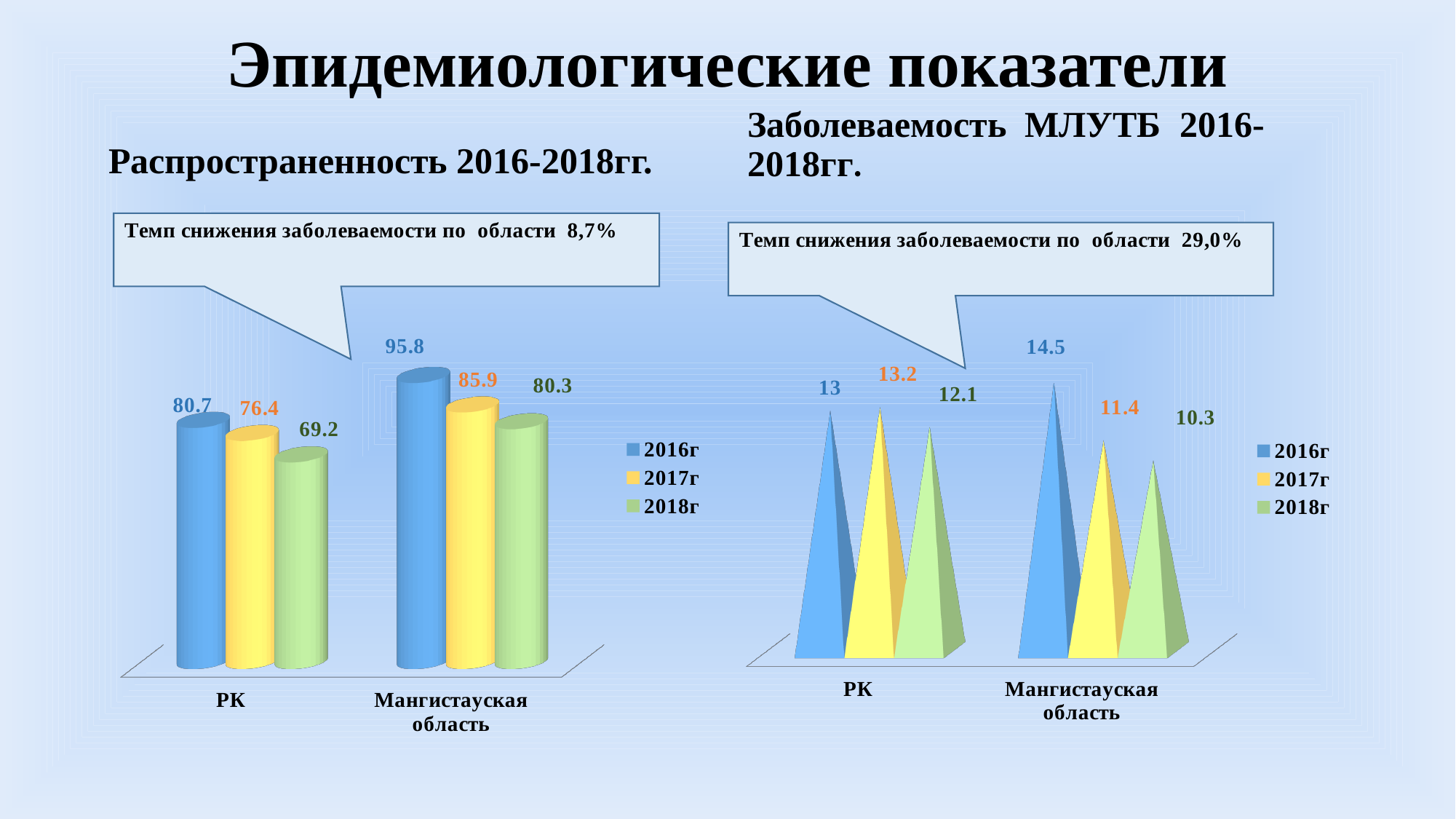
In the right chart (Заболеваемость МЛУТБ 2016-2018гг.), what is the difference between the 2016г and 2017г values for Мангистауская область? 3.1 What kind of chart is the right chart (Заболеваемость МЛУТБ 2016-2018гг.)? bar chart How many series does the legend of the left chart (Распространенность 2016-2018гг.) list? 3 In the left chart (Распространенность 2016-2018гг.), what is the value for РК in 2016г? 80.7 In the left chart (Распространенность 2016-2018гг.), do the values for РК rise or fall from 2016г to 2018г? fall In the left chart (Распространенность 2016-2018гг.), what is the difference between the 2016г and 2018г values for РК? 11.5 In the left chart (Распространенность 2016-2018гг.), what is the value for Мангистауская область in 2018г? 80.3 In the right chart (Заболеваемость МЛУТБ 2016-2018гг.), what is the value for Мангистауская область in 2016г? 14.5 In the left chart (Распространенность 2016-2018гг.), which year has the highest value for Мангистауская область? 2016г In the right chart (Заболеваемость МЛУТБ 2016-2018гг.), which year has the lowest value for Мангистауская область? 2018г In the right chart (Заболеваемость МЛУТБ 2016-2018гг.), what is the value for РК in 2017г? 13.2 In the right chart (Заболеваемость МЛУТБ 2016-2018гг.), which is larger: the 2018г value for РК or the 2018г value for Мангистауская область? РК